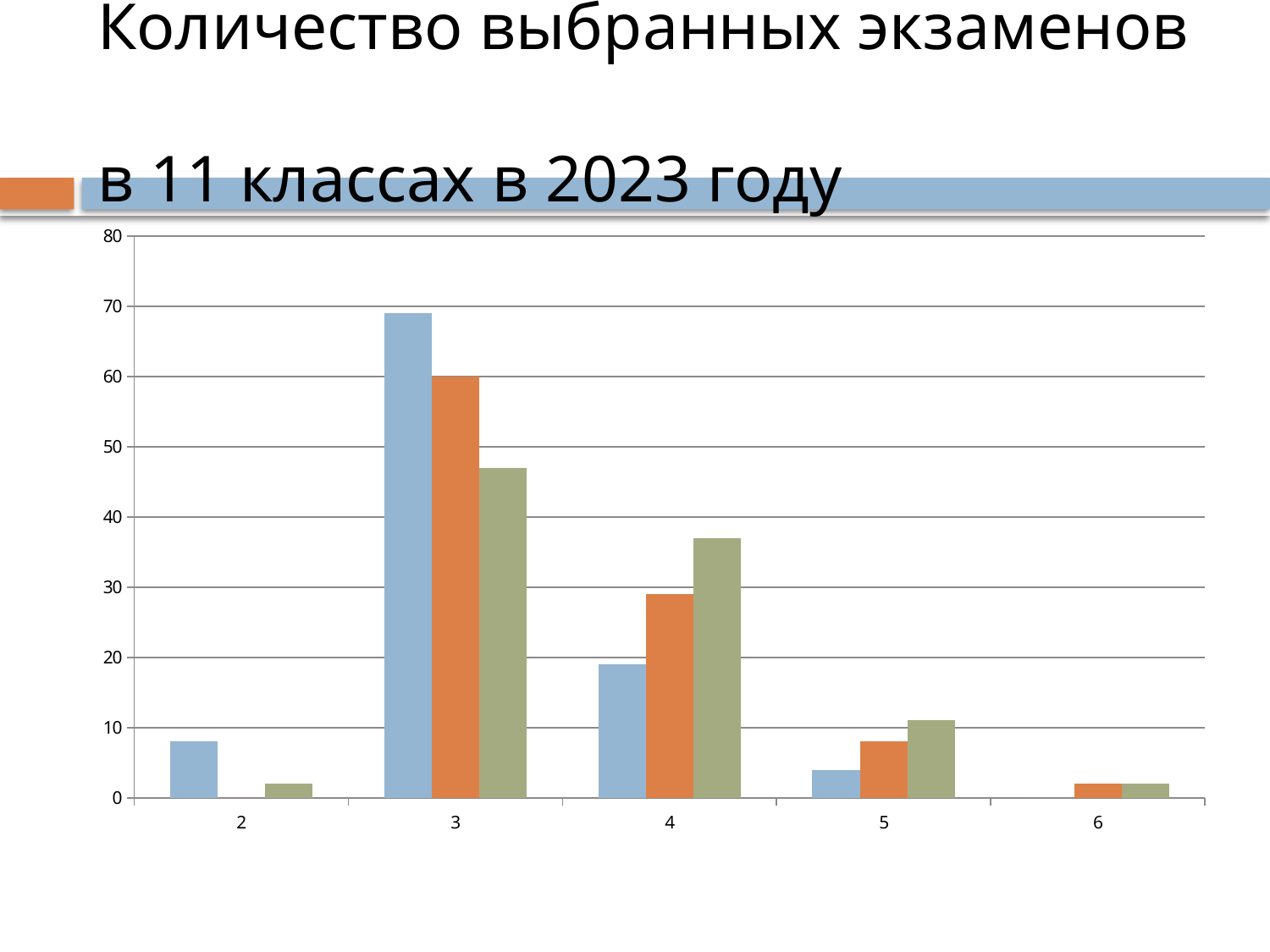
For which category is the blue bar highest? 3 For which category is the green bar highest? 3 How many bars are shown for category 3? 3 Which is larger for category 4: the orange bar or the green bar? the green bar What kind of chart is shown on the slide? bar chart Is the value of the blue bar for category 3 greater or less than 60? greater What is the title of the chart? Количество выбранных экзаменов в 11 классах в 2023 году Is the value of the green bar for category 4 greater or less than 30? greater Which is larger for category 3: the blue bar or the green bar? the blue bar What is the value of the orange bar for category 3? 60 How many categories are shown on the x axis? 5